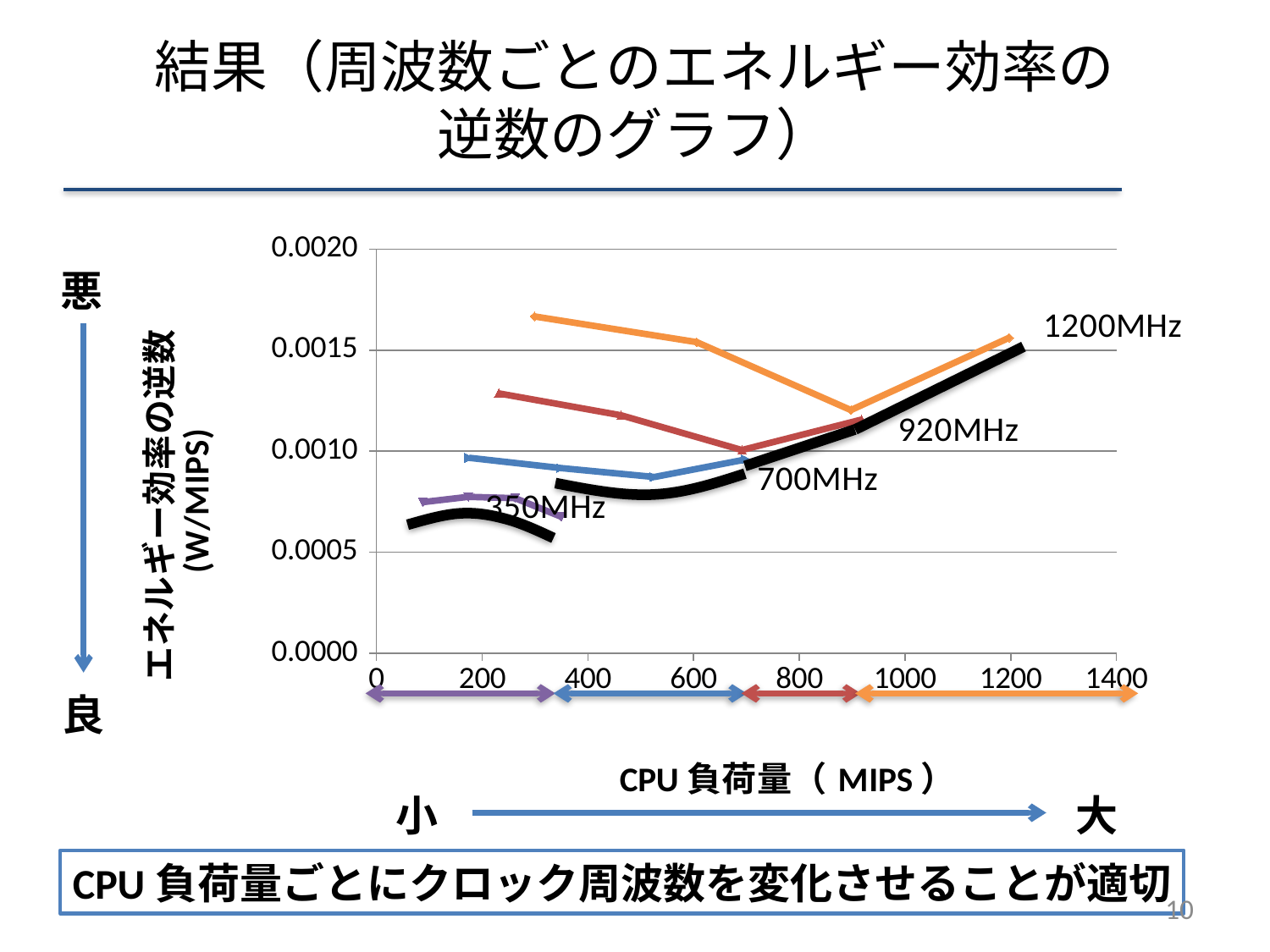
What is the highest tick value shown on the y axis? 0.0020 Does the 1200MHz series rise or fall between about 300 and 900 MIPS? fall Is the first (leftmost) value of the 1200MHz series greater or less than 0.0015? greater Is the first (leftmost) value of the 920MHz series greater or less than 0.0010? greater Which series reaches the highest value on the chart? 1200MHz Is the lowest value of the 700MHz series greater or less than 0.0010? less At around 300 MIPS, which series has the higher value: 1200MHz or 350MHz? 1200MHz What kind of chart is shown on the slide? line chart Which series has the lowest values on the chart? 350MHz What is the unit shown on the y-axis label? W/MIPS How many frequency series are plotted on the chart? 4